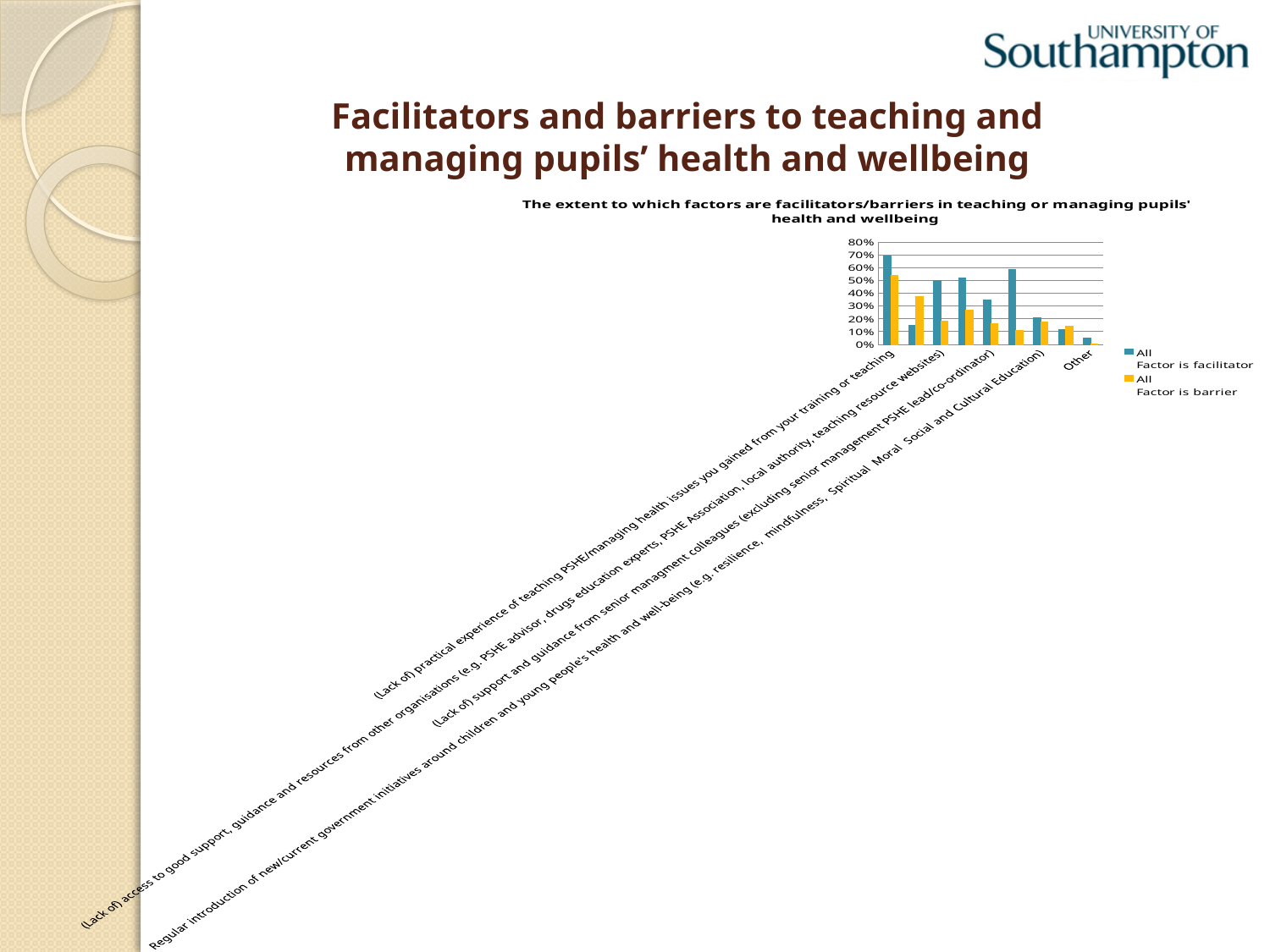
Is the 'Factor is barrier' value for '(Lack of) practical experience of teaching PSHE/managing health issues you gained from your training or teaching' greater or less than 40%? greater Which category has the highest 'Factor is facilitator' value? (Lack of) practical experience of teaching PSHE/managing health issues you gained from your training or teaching How many categories are plotted along the x axis of the chart? 9 Which category has the highest 'Factor is barrier' value? (Lack of) practical experience of teaching PSHE/managing health issues you gained from your training or teaching What kind of chart is shown on the slide? Bar chart What is the title of the chart? The extent to which factors are facilitators/barriers in teaching or managing pupils' health and wellbeing How many series does the chart's legend list? 2 For '(Lack of) practical experience of teaching PSHE/managing health issues you gained from your training or teaching', which is larger: the 'Factor is facilitator' value or the 'Factor is barrier' value? Factor is facilitator Is the 'Factor is facilitator' value for '(Lack of) practical experience of teaching PSHE/managing health issues you gained from your training or teaching' greater or less than 60%? greater For 'Other', which is larger: the 'Factor is facilitator' value or the 'Factor is barrier' value? Factor is facilitator Is the 'Factor is barrier' value for 'Other' greater or less than 10%? less Which colour represents the 'All Factor is barrier' series in the chart? Yellow